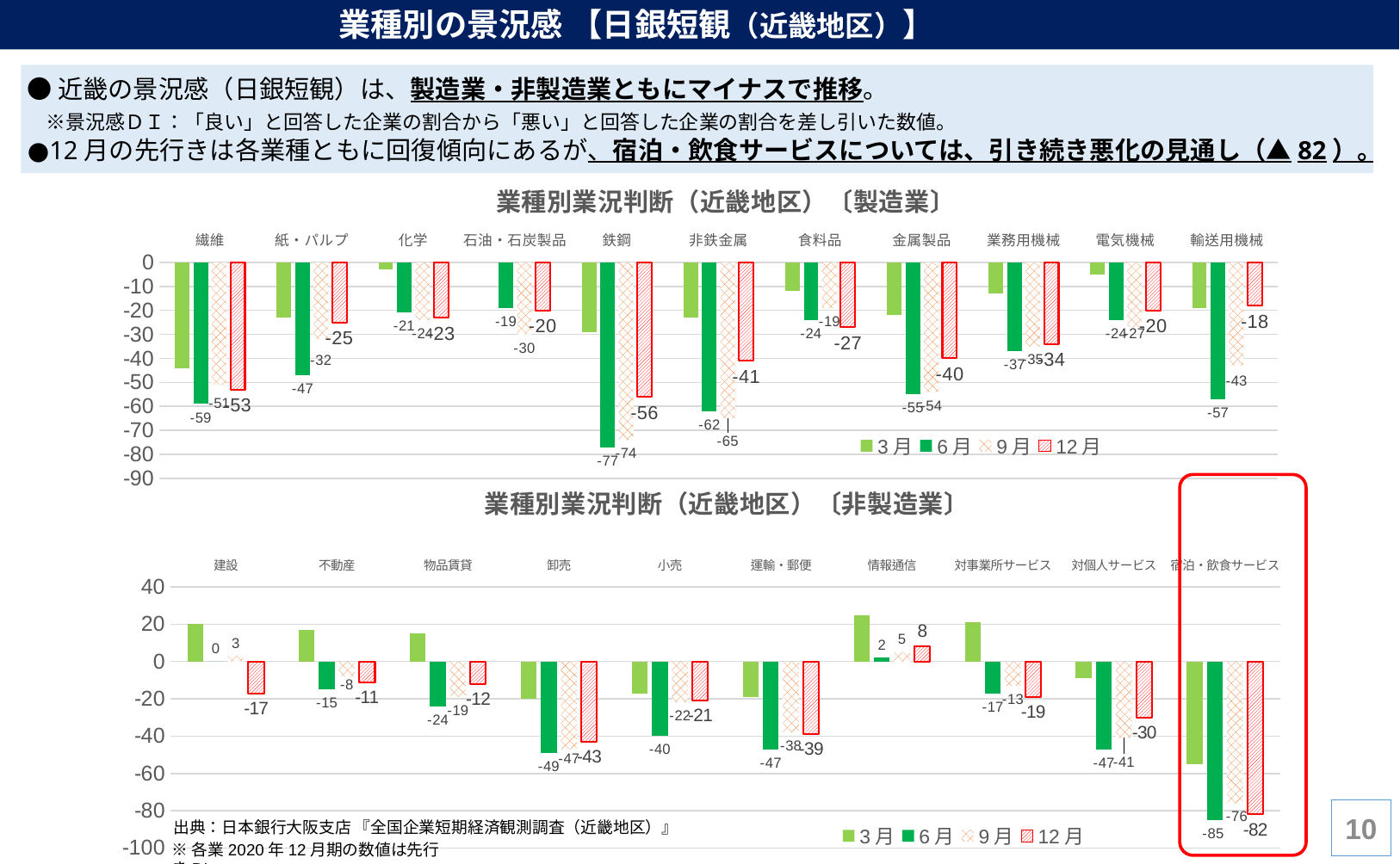
In the 非製造業 chart (bottom), which is larger, the 12月 value for 小売 or the 12月 value for 卸売? 小売 In the 製造業 chart (top), which industry has the lowest 6月 value? 鉄鋼 In the 製造業 chart (top), what is the 12月 value for 輸送用機械? -18 In the 製造業 chart (top), what is the difference between the 6月 and 12月 values for 輸送用機械? 39 In the 製造業 chart (top), what is the 6月 value for 鉄鋼? -77 What kind of chart is the 製造業 chart (top)? bar chart In the 非製造業 chart (bottom), is the 3月 value for 情報通信 greater or less than 20? greater In the 非製造業 chart (bottom), which industry has the highest 12月 value? 情報通信 How many industries are shown in the 非製造業 chart (bottom)? 10 How many series does the legend of the 製造業 chart (top) list? 4 In the 非製造業 chart (bottom), what is the 12月 value for 宿泊・飲食サービス? -82 In the 非製造業 chart (bottom), which industry has the lowest 6月 value? 宿泊・飲食サービス